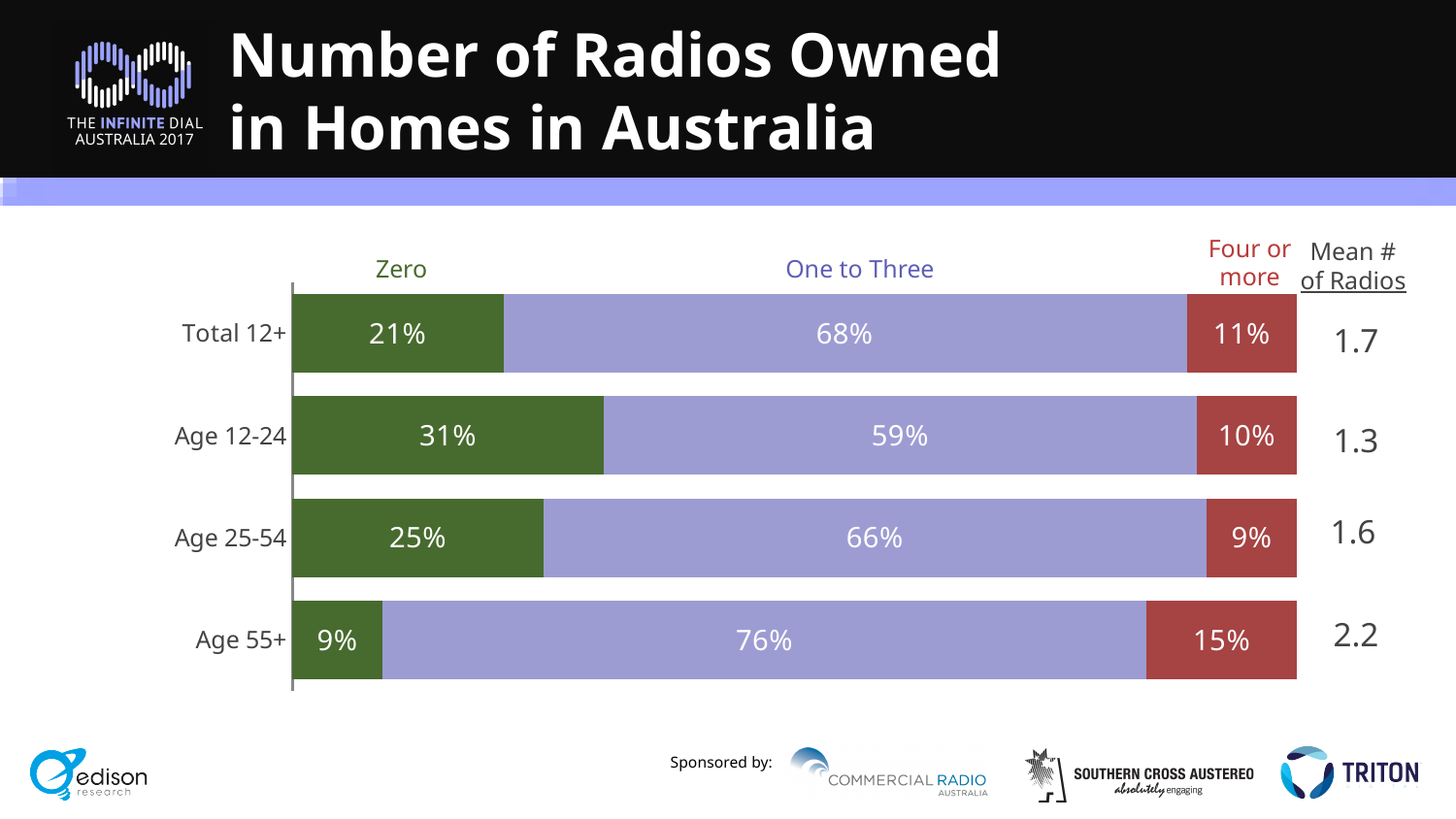
Which group has the lowest share owning four or more radios? Age 25-54 What is the mean number of radios for the Age 25-54 group? 1.6 What is the difference between the Zero share for Age 12-24 and Age 55+? 22 percentage points How many series does the chart show across each bar? 3 Which age group has the highest share owning zero radios? Age 12-24 Which is larger: the One to Three share for Age 25-54 or for Age 12-24? Age 25-54 Which group has the highest mean number of radios? Age 55+ What percentage of the Age 55+ group owns one to three radios? 76% What percentage of the Age 12-24 group owns four or more radios? 10% What type of chart is shown on the slide? Stacked bar chart What percentage of the Total 12+ group owns zero radios? 21% How many groups (bars) are shown in the chart? 4